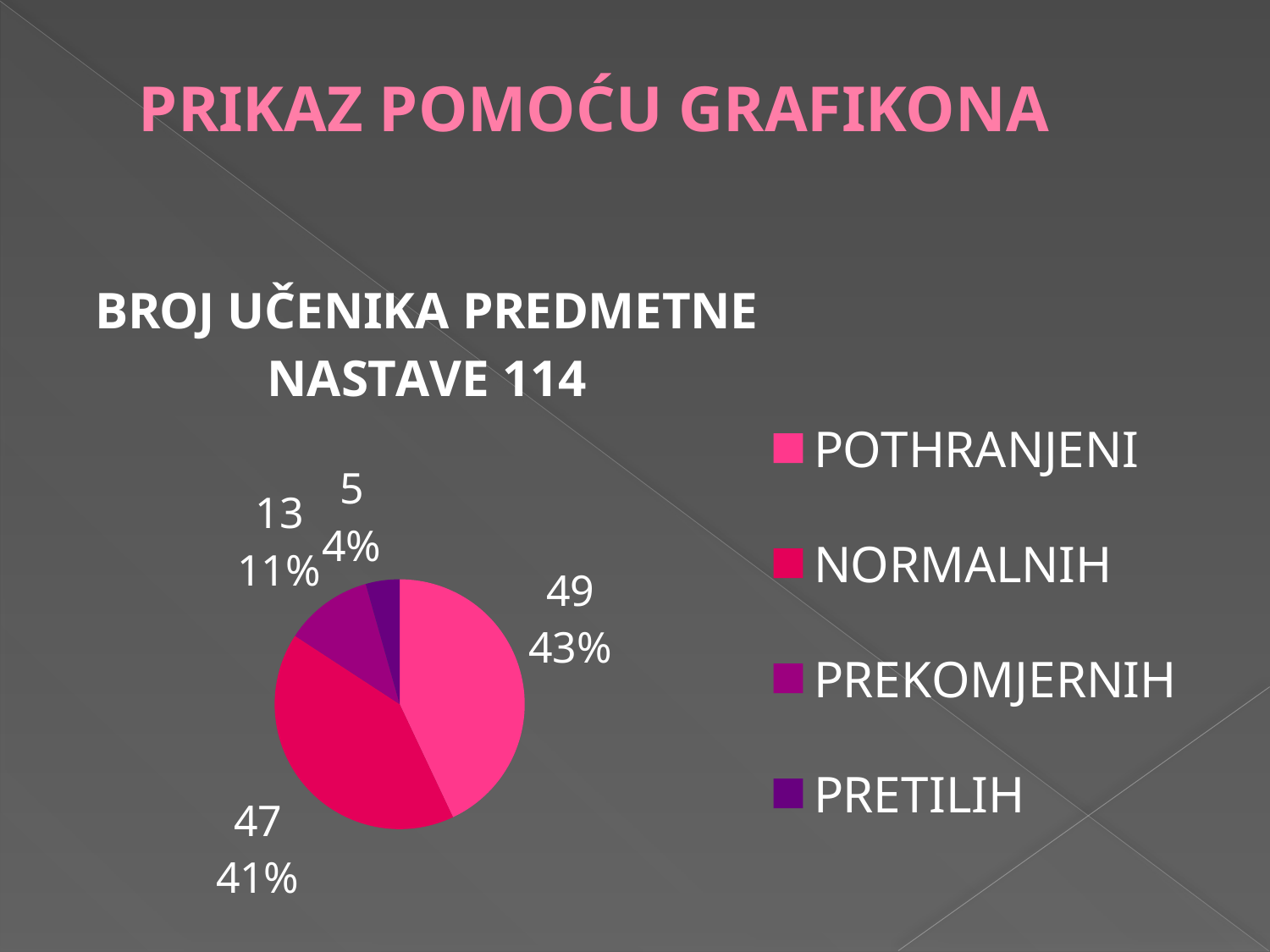
How many students are in the PRETILIH category? 5 How many students are in the PREKOMJERNIH category? 13 What share of the pie does the PRETILIH slice represent? 4% How many students are in the NORMALNIH category? 47 How many slices does the pie chart have? 4 What is the difference between the POTHRANJENI and PREKOMJERNIH counts? 36 What share of the pie does the NORMALNIH slice represent? 41% Which category has the smallest slice? PRETILIH How many students are in the POTHRANJENI category? 49 How many entries does the legend list? 4 What is the title of the chart? BROJ UČENIKA PREDMETNE NASTAVE 114 What kind of chart is shown on the slide? pie chart